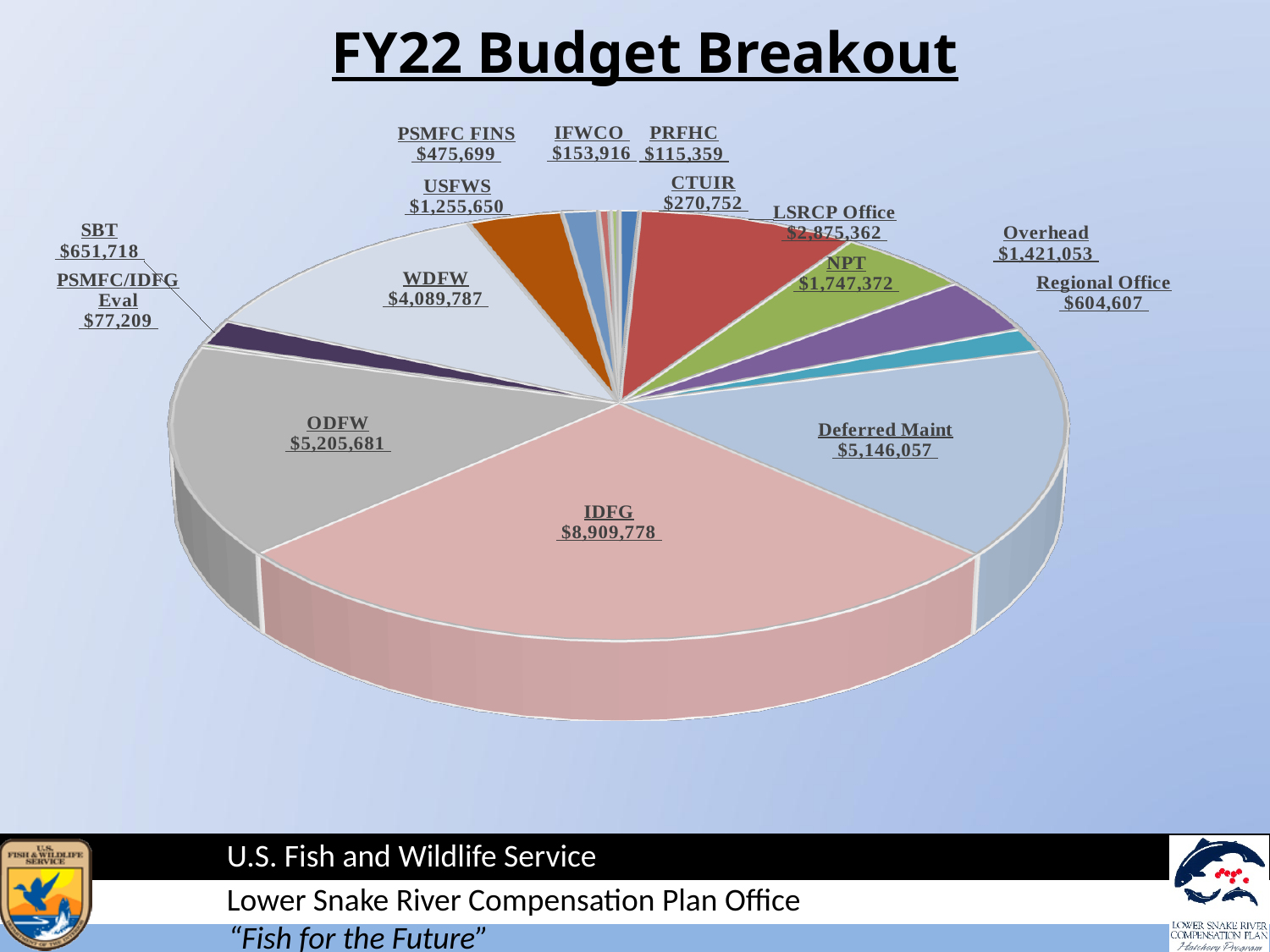
What kind of chart is shown on the slide? Pie chart What is the value for IDFG? $8,909,778 What is the title of the chart? FY22 Budget Breakout What is the difference between the IDFG and ODFW values? $3,704,097 What is the difference between the Overhead and Regional Office values? $816,446 Which category has the smallest slice? PSMFC/IDFG Eval Which category has the largest slice? IDFG Which is larger, WDFW or Deferred Maint? Deferred Maint What is the value for LSRCP Office? $2,875,362 What is the value for PSMFC FINS? $475,699 What is the value for Deferred Maint? $5,146,057 How many categories are shown in the pie chart? 15